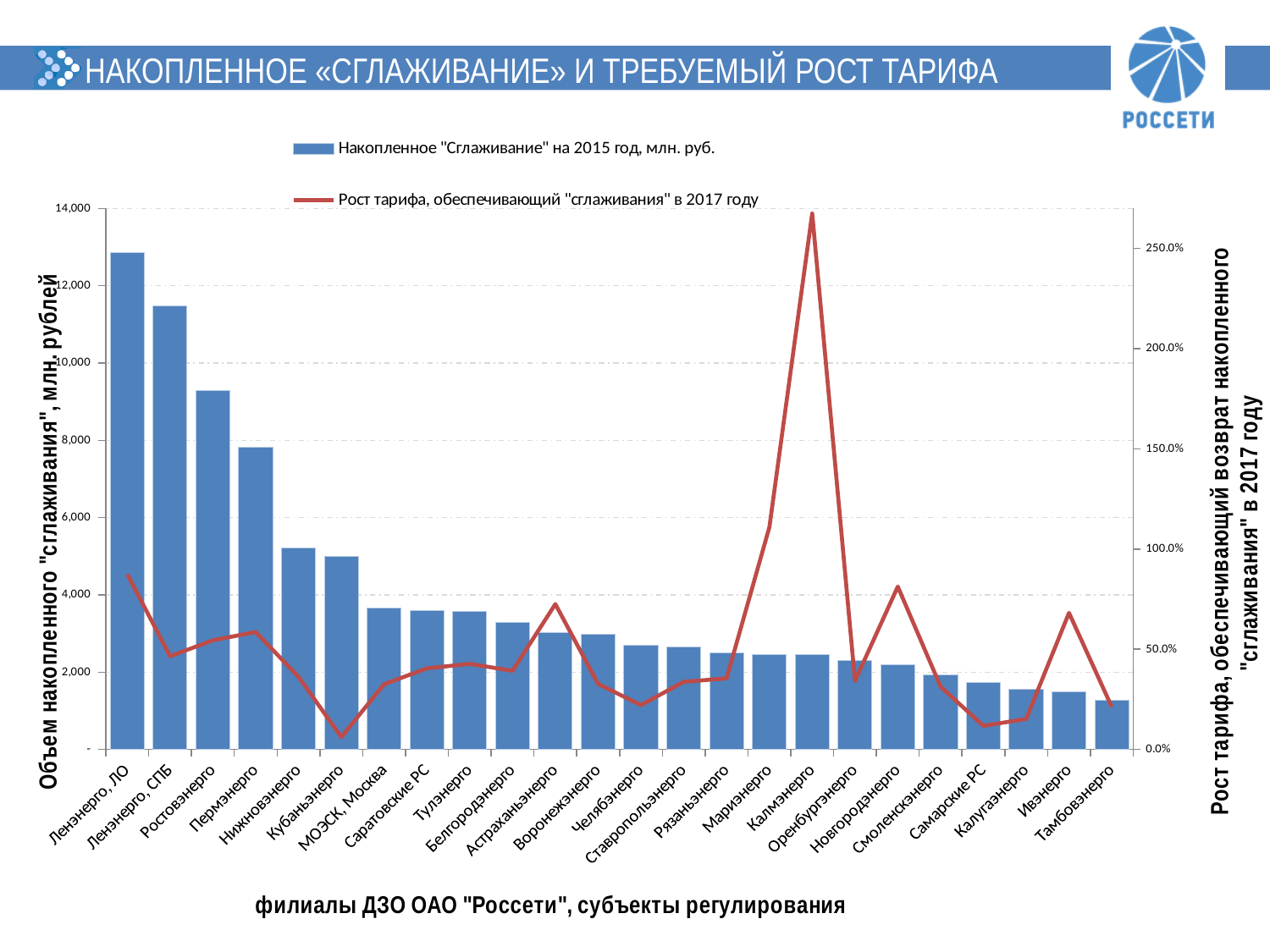
Is the tariff growth value for Калмэнерго greater or less than 250.0%? greater Which has the larger accumulated "smoothing" bar, Ленэнерго, СПБ or Ростовэнерго? Ленэнерго, СПБ Which branch has the highest accumulated "smoothing" bar? Ленэнерго, ЛО Is the accumulated "smoothing" bar for Ростовэнерго greater or less than 8,000? greater Is the accumulated "smoothing" bar for Ленэнерго, ЛО greater or less than 12,000? greater Which branch has the highest required tariff growth on the line series? Калмэнерго What kind of chart is shown on the slide? A combined bar and line chart How many categories (branches) are shown along the x axis? 24 Which branch has the lowest accumulated "smoothing" bar? Тамбовэнерго What colour are the accumulated "smoothing" bars? Blue How many series does the legend list? 2 Do the accumulated "smoothing" bars rise or fall from left to right along the x axis? Fall